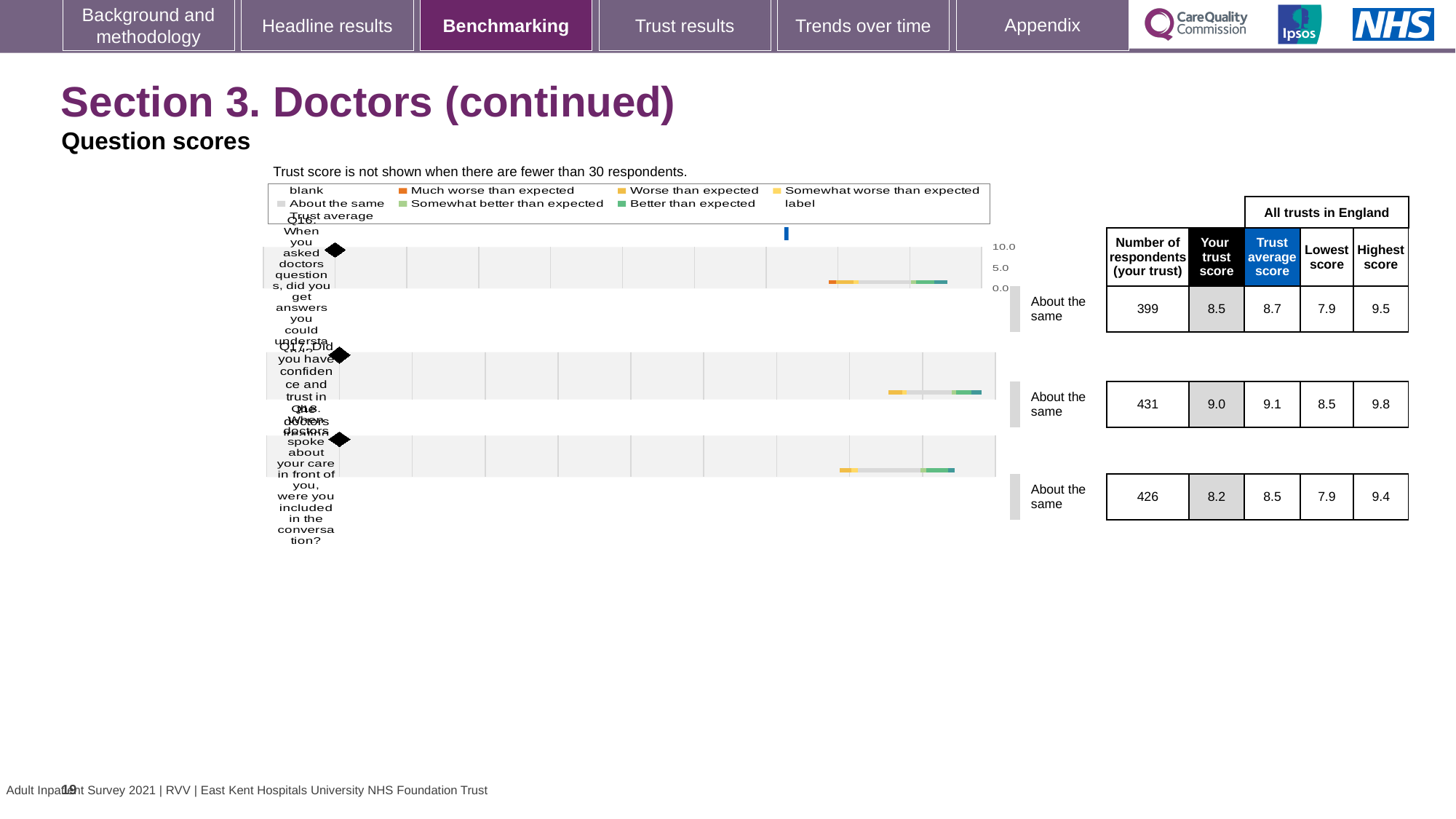
Is the trust score for Q16 larger or smaller than the trust average score for Q16? smaller What is the difference between the trust score for Q17 and the trust score for Q18? 0.8 What is the trust score for Q18 (When doctors spoke about your care in front of you, were you included in the conversation?)? 8.2 What is the maximum value shown on the chart's score axis? 10.0 How many questions are plotted on the chart? 3 What is the number of respondents for Q17? 431 What is the trust score for Q16 (When you asked doctors questions, did you get answers you could understand?)? 8.5 What benchmark category is shown for each of the three questions on the chart? About the same Which of the three questions plotted has the highest trust score? Q17 Which of the three questions plotted has the lowest trust score? Q18 What is the highest score across all trusts in England for Q18? 9.4 What is the trust score for Q17 (Did you have confidence and trust in the doctors treating you?) shown in the table next to the chart? 9.0